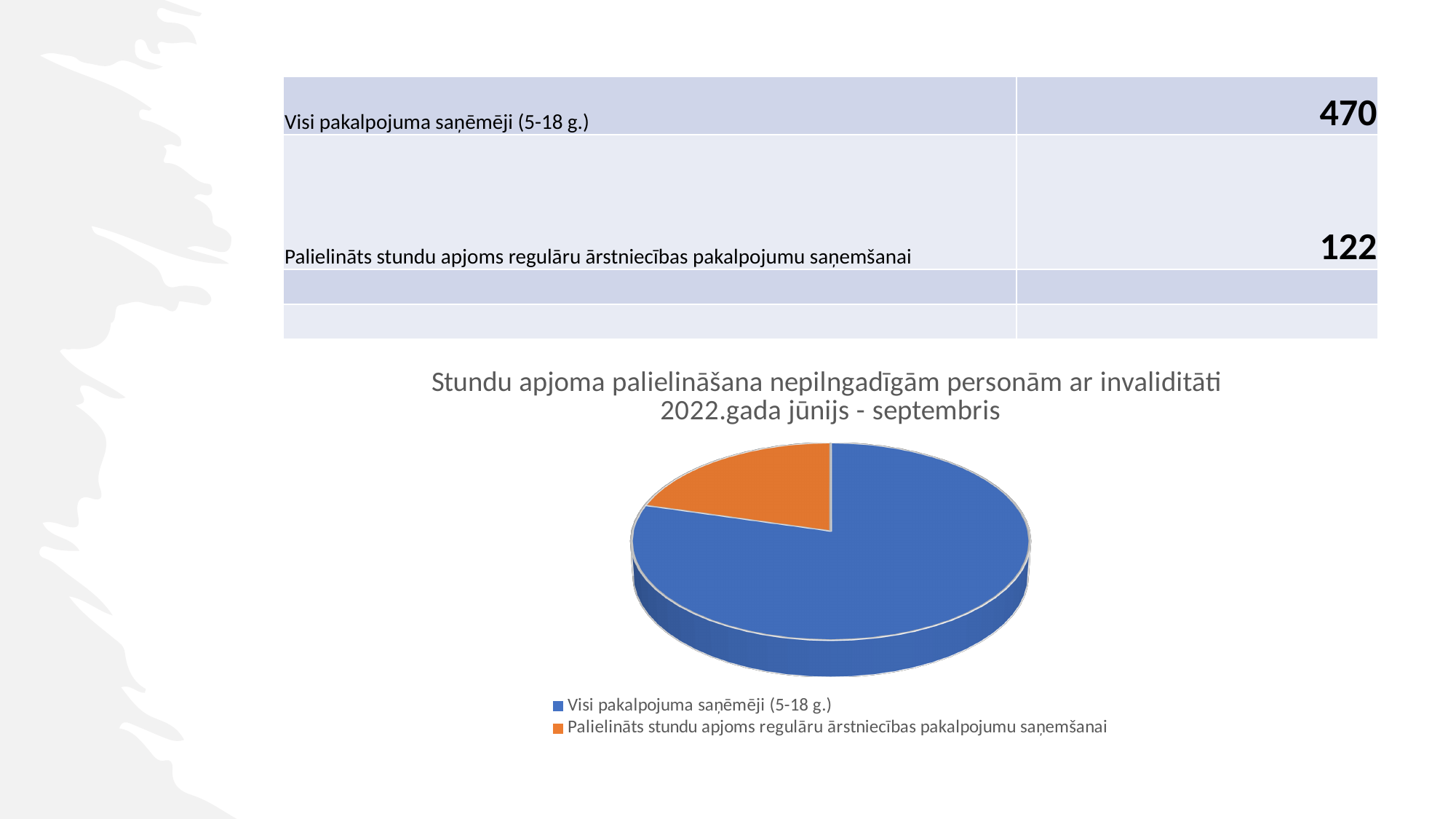
Which is larger: the value for 'Visi pakalpojuma saņēmēji (5-18 g.)' or for 'Palielināts stundu apjoms regulāru ārstniecības pakalpojumu saņemšanai'? Visi pakalpojuma saņēmēji (5-18 g.) Which colour represents 'Palielināts stundu apjoms regulāru ārstniecības pakalpojumu saņemšanai' in the pie chart? orange What type of chart is shown on the slide? pie chart What is the value for 'Palielināts stundu apjoms regulāru ārstniecības pakalpojumu saņemšanai'? 122 How many slices does the pie chart have? 2 Which category has the smallest slice in the pie chart? Palielināts stundu apjoms regulāru ārstniecības pakalpojumu saņemšanai What is the title of the pie chart? Stundu apjoma palielināšana nepilngadīgām personām ar invaliditāti 2022.gada jūnijs - septembris How many entries does the legend of the pie chart list? 2 What is the difference between the value for 'Visi pakalpojuma saņēmēji (5-18 g.)' and the value for 'Palielināts stundu apjoms regulāru ārstniecības pakalpojumu saņemšanai'? 348 What is the value for 'Visi pakalpojuma saņēmēji (5-18 g.)'? 470 Which category has the largest slice in the pie chart? Visi pakalpojuma saņēmēji (5-18 g.)